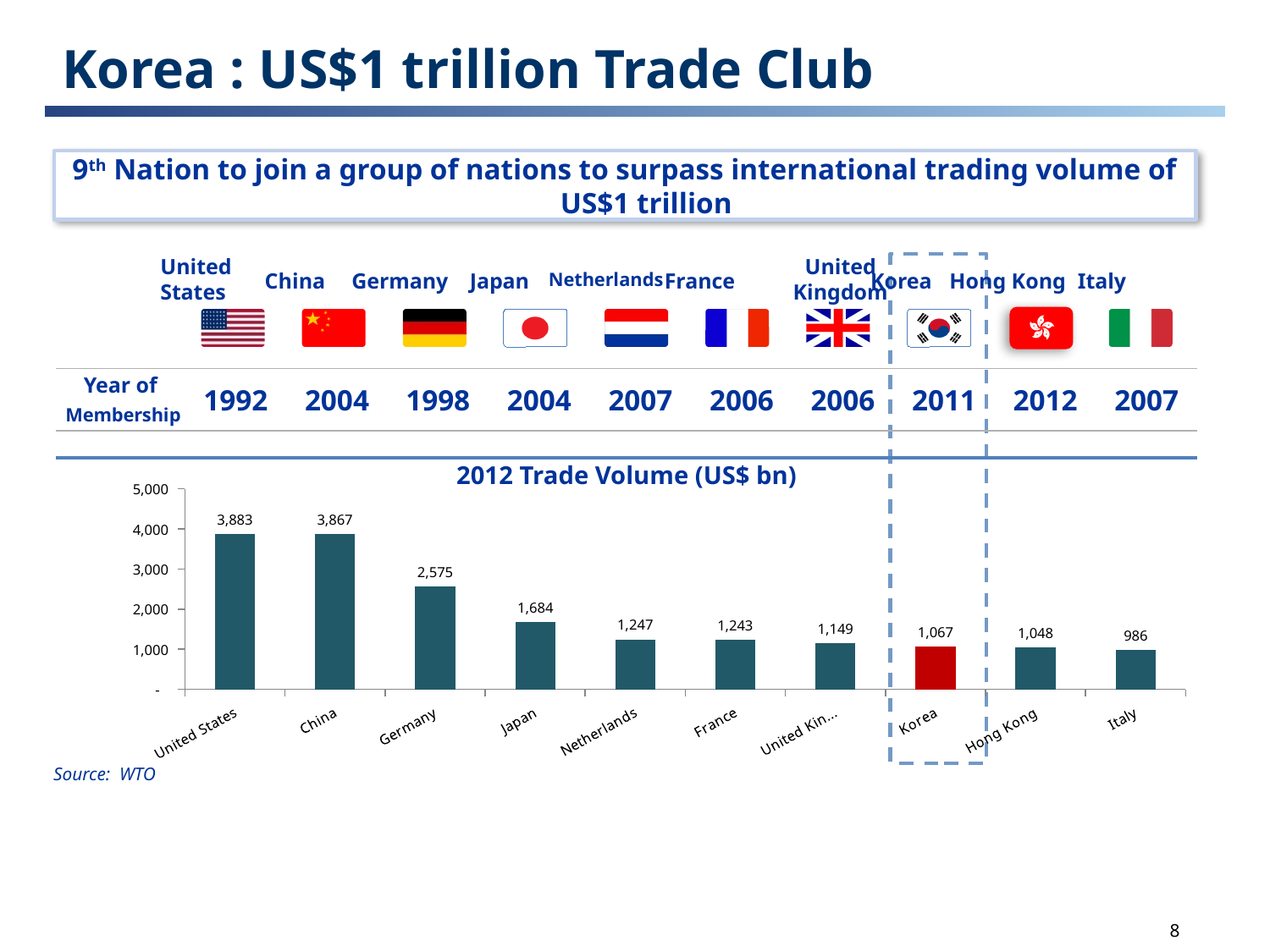
What kind of chart is used to show the 2012 trade volume? Bar chart Which has a larger 2012 trade volume, Netherlands or France? Netherlands What is the difference between the 2012 trade volumes of Korea and Hong Kong? 19 What is the 2012 trade volume for Korea in the chart? 1,067 Which country has the highest 2012 trade volume in the chart? United States Which bar in the 2012 Trade Volume chart is coloured red? Korea What is the 2012 trade volume for Italy in the chart? 986 What is the 2012 trade volume for Germany in the chart? 2,575 What is the difference between the 2012 trade volumes of Germany and Japan? 891 Is the value for Japan greater or less than 2,000? less How many countries are shown in the 2012 Trade Volume chart? 10 Which country has the lowest 2012 trade volume in the chart? Italy